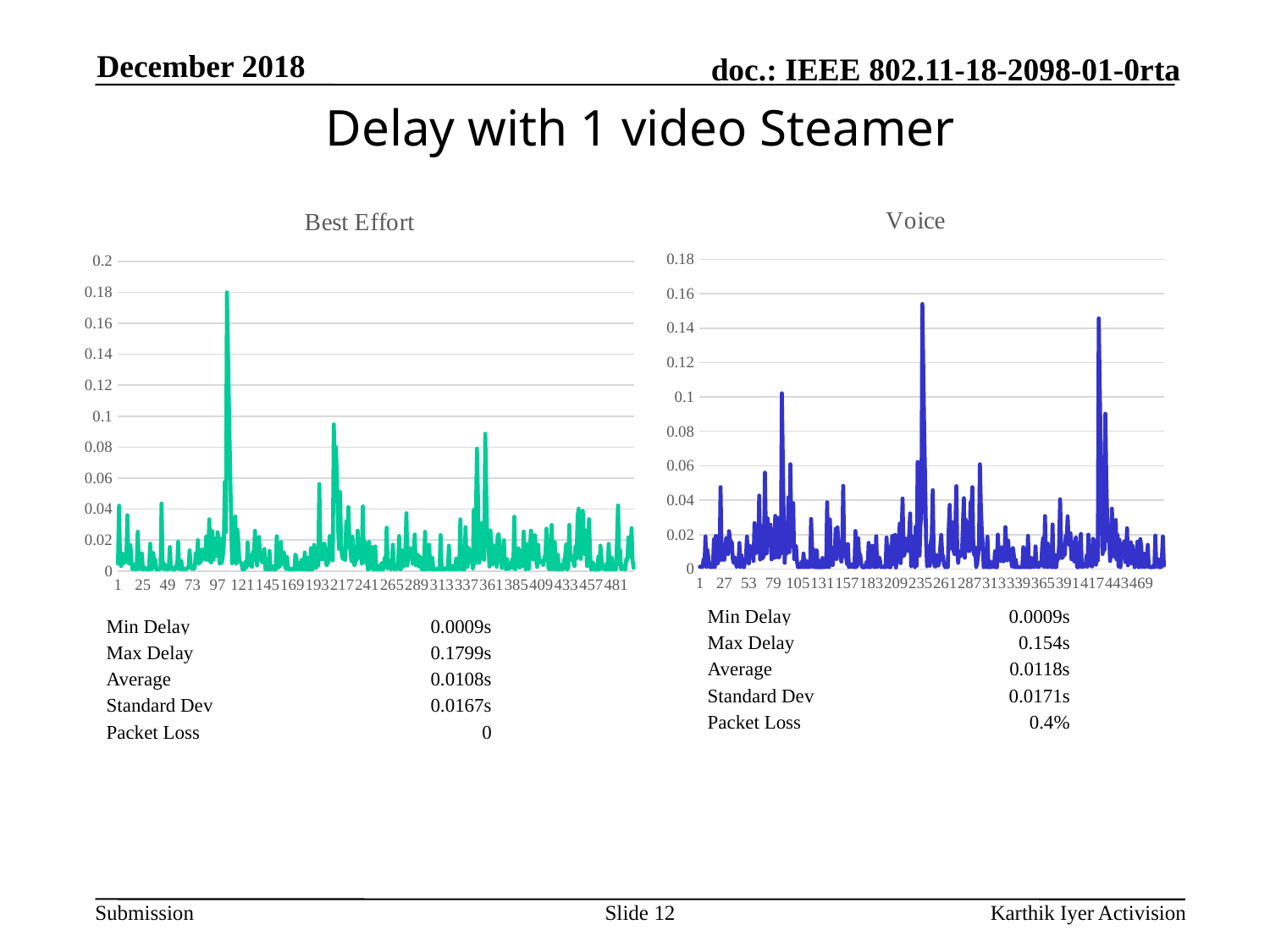
What colour is the line in the Voice chart? blue In the Voice chart, is the highest peak greater or less than 0.18? less In the Voice chart, is the highest peak greater or less than 0.14? greater What kind of chart is the Voice chart? line chart What is the title of the chart on the left side of the slide? Best Effort What kind of chart is the Best Effort chart? line chart In the Best Effort chart, is the highest peak greater or less than 0.16? greater